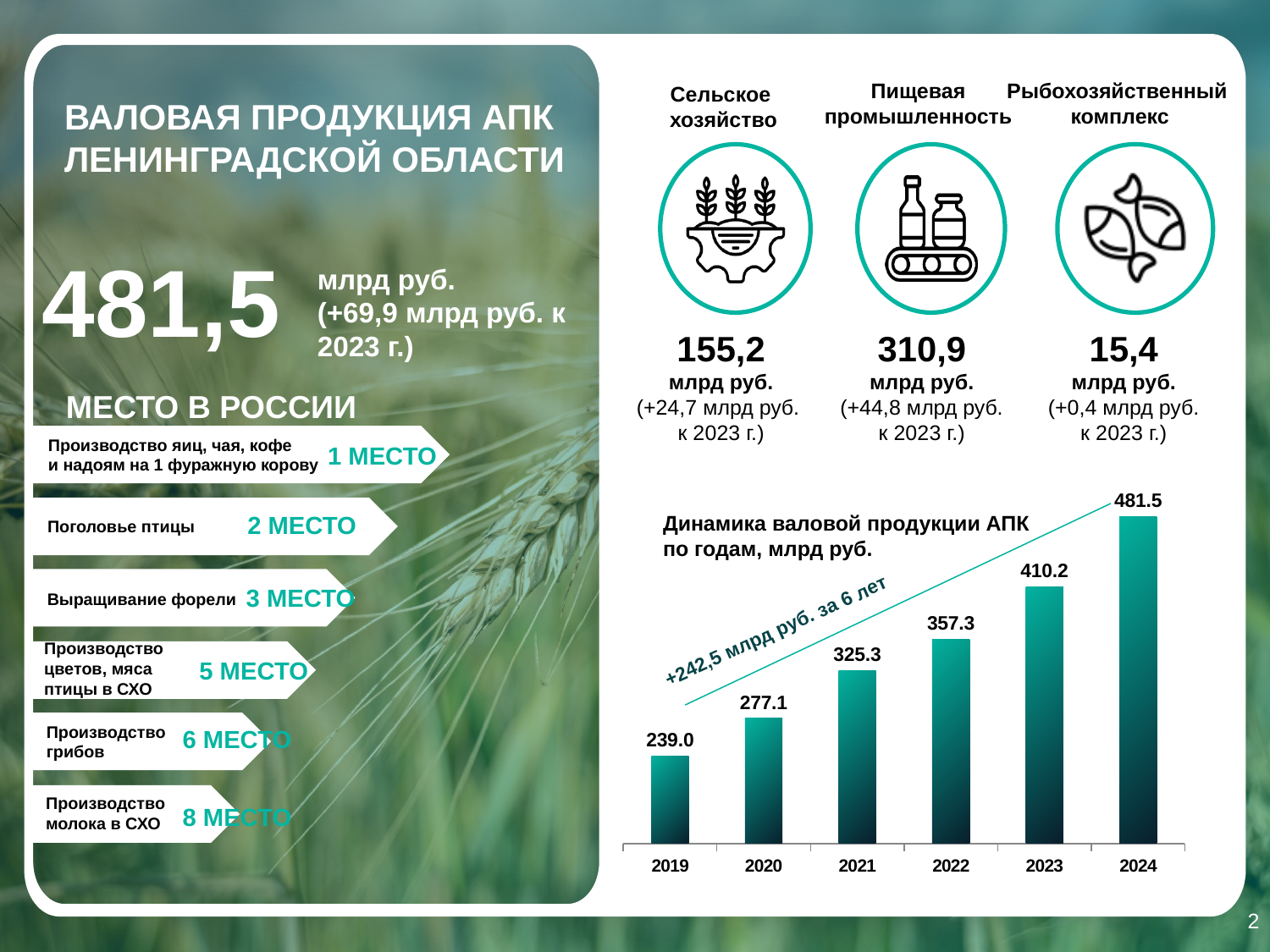
Do the values in the chart 'Динамика валовой продукции АПК по годам, млрд руб.' rise or fall from 2019 to 2024? rise Which year has the lowest value in the chart 'Динамика валовой продукции АПК по годам, млрд руб.'? 2019 Which year has the highest value in the chart 'Динамика валовой продукции АПК по годам, млрд руб.'? 2024 What kind of chart is 'Динамика валовой продукции АПК по годам, млрд руб.'? bar chart In the chart 'Динамика валовой продукции АПК по годам, млрд руб.', what is the difference between the values for 2021 and 2020? 48.2 What is the value for 2024 in the chart 'Динамика валовой продукции АПК по годам, млрд руб.'? 481.5 What is the value for 2022 in the chart 'Динамика валовой продукции АПК по годам, млрд руб.'? 357.3 What growth over 6 years is annotated along the trend line in the chart 'Динамика валовой продукции АПК по годам, млрд руб.'? +242,5 млрд руб. за 6 лет What is the value for 2019 in the chart 'Динамика валовой продукции АПК по годам, млрд руб.'? 239.0 How many years are shown in the chart 'Динамика валовой продукции АПК по годам, млрд руб.'? 6 In the chart 'Динамика валовой продукции АПК по годам, млрд руб.', which is larger: the value for 2020 or the value for 2022? 2022 In the chart 'Динамика валовой продукции АПК по годам, млрд руб.', what is the difference between the values for 2024 and 2023? 71.3